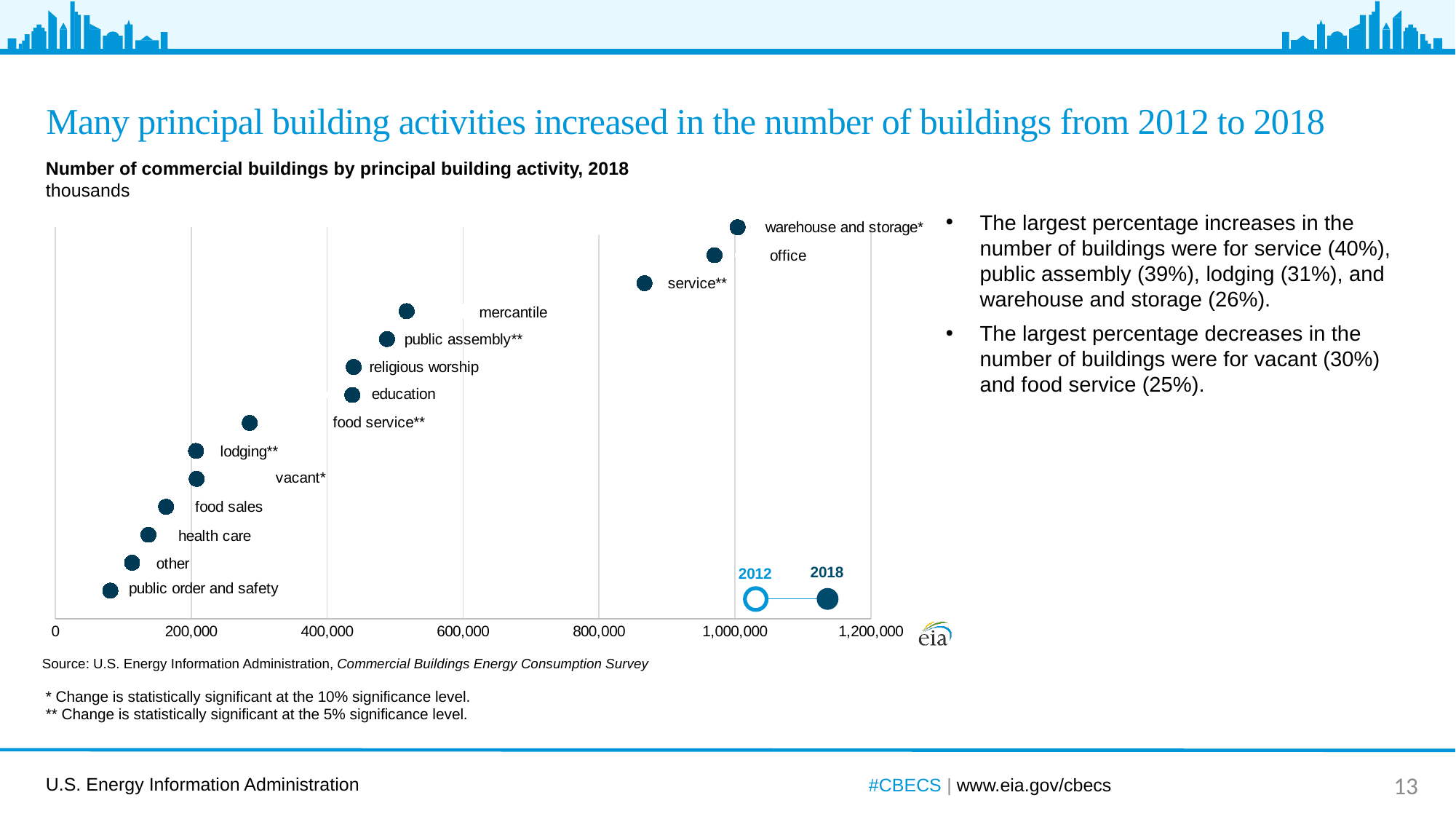
Is the value for food service** greater or less than 400,000? less Which has more buildings in 2018, service** or mercantile? service** Is the value for service** greater or less than 800,000? greater How many series does the chart legend list? 2 Is the value for food sales greater or less than 200,000? less Which principal building activity has the highest number of buildings in 2018? warehouse and storage* What kind of chart is shown on the slide? dot plot (scatter chart) What unit are the values on the chart expressed in? thousands How many principal building activities are plotted on the chart? 14 Which has more buildings in 2018, food service** or health care? food service** Which principal building activity has the lowest number of buildings in 2018? public order and safety